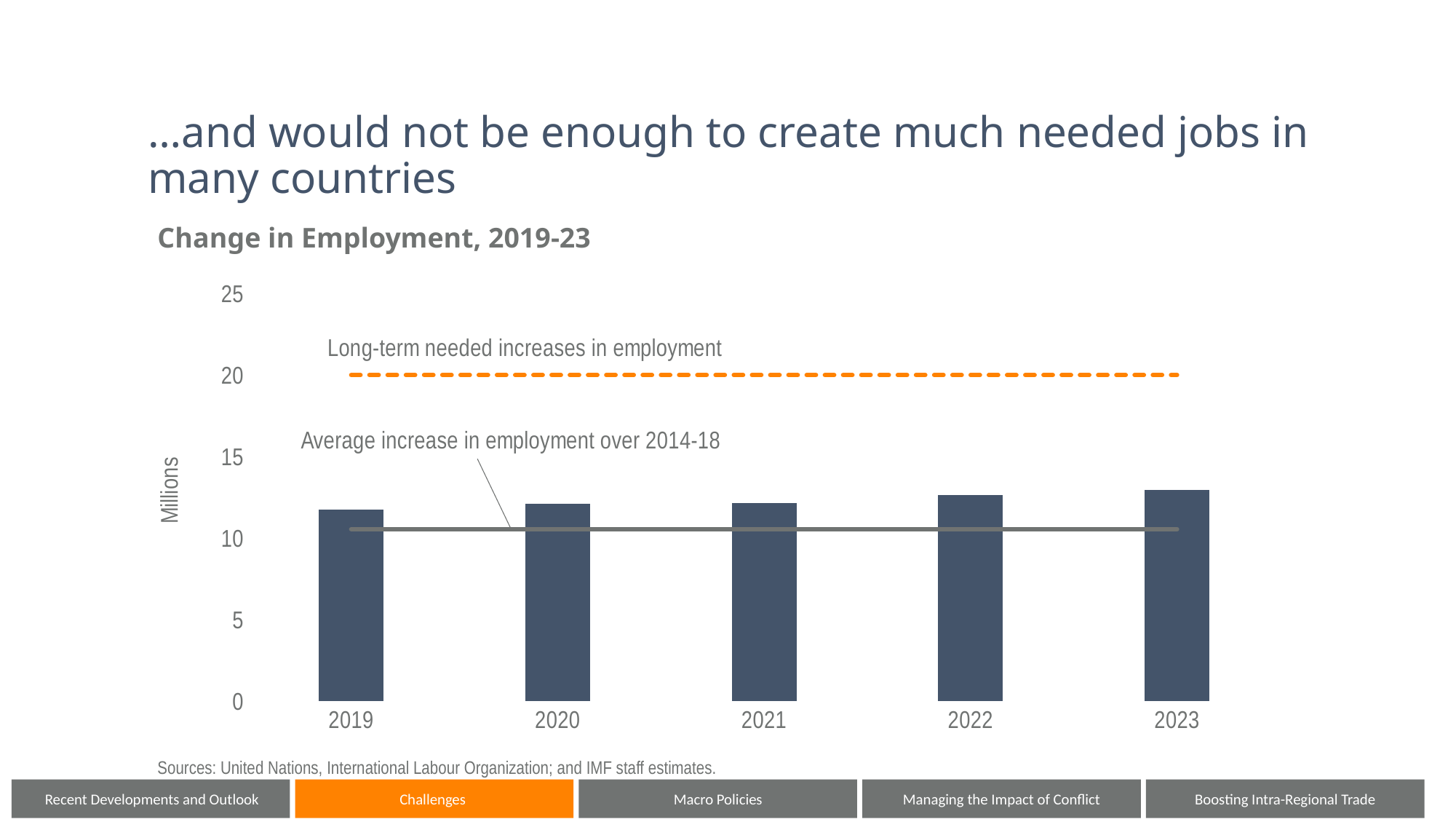
What is the title of the chart? Change in Employment, 2019-23 Which is larger, the bar for 2019 or the bar for 2023? 2023 What kind of chart is shown on the slide? bar chart Which year has the highest bar in the chart? 2023 Is the value for 2019 greater or less than 10? greater Is the value for 2021 greater or less than 15? less Is the dashed line for long-term needed increases in employment greater or less than 15? greater What is the label on the vertical axis of the chart? Millions Do the bar values generally rise or fall from 2019 to 2023? rise Which year has the lowest bar in the chart? 2019 How many years are plotted as bars in the chart? 5